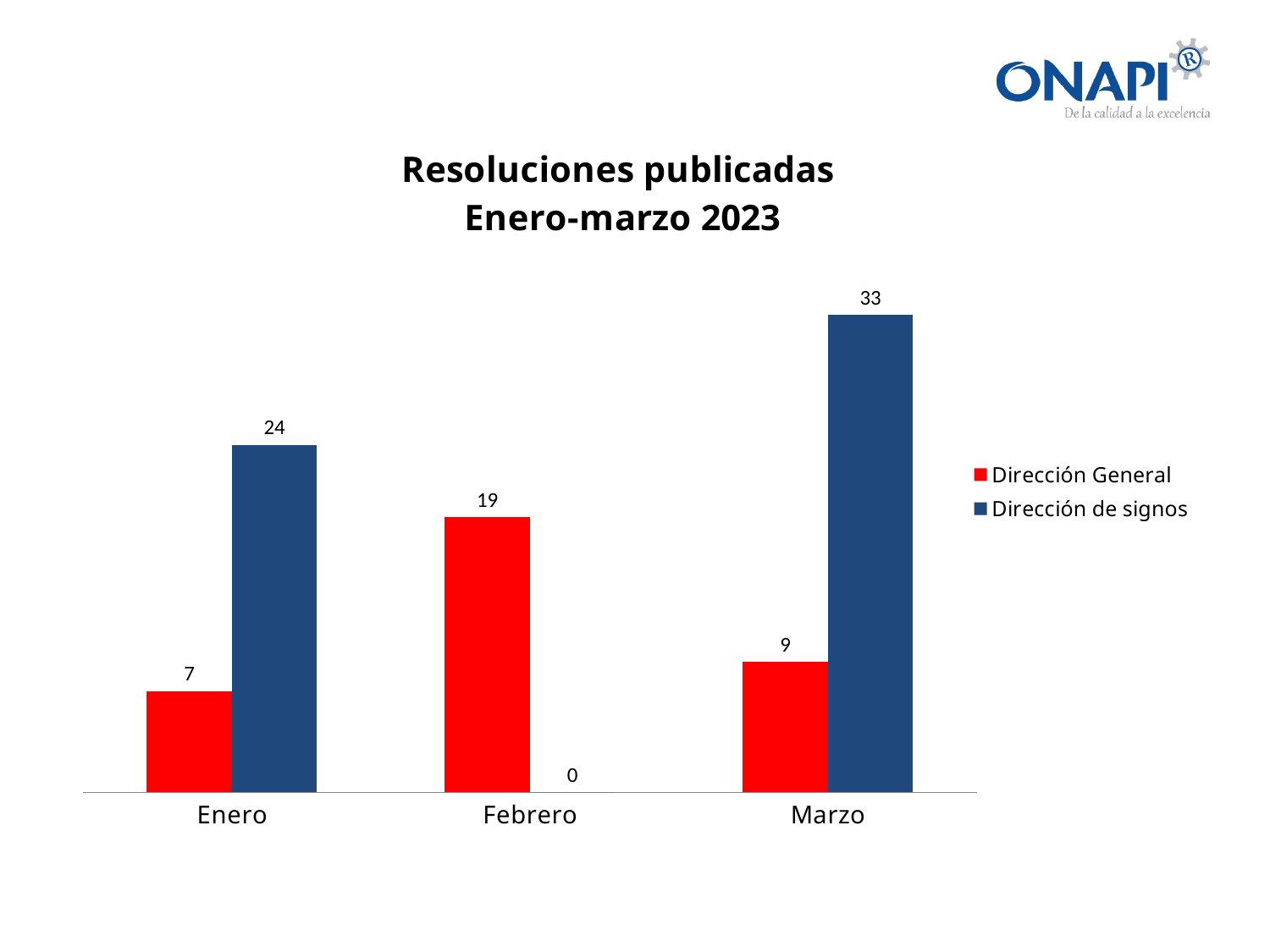
How many series does the legend list? 2 What is the difference between Dirección de signos and Dirección General in Marzo? 24 What is the value for Dirección de signos in Marzo? 33 What is the value for Dirección de signos in Febrero? 0 What is the value for Dirección General in Enero? 7 In which month is the Dirección de signos value highest? Marzo How many months are shown on the x axis? 3 What is the title of the chart? Resoluciones publicadas Enero-marzo 2023 Which is larger in Enero, Dirección General or Dirección de signos? Dirección de signos What kind of chart is shown? Bar chart In which month is the Dirección General value lowest? Enero What is the value for Dirección General in Febrero? 19